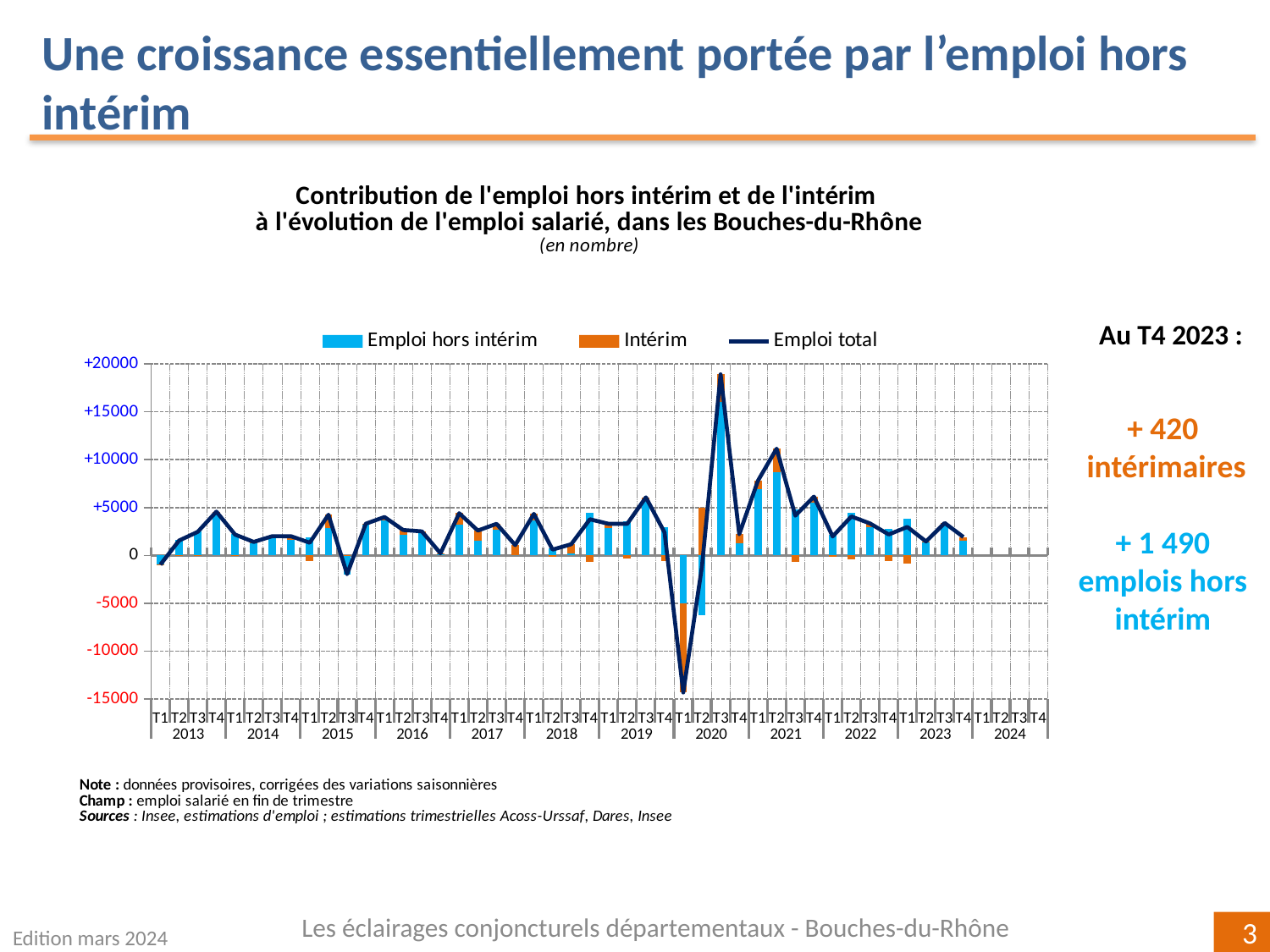
What colour are the Intérim bars in the chart? Orange Is the Emploi total value for T2 2021 greater or less than +5000? greater What kind of chart is shown on the slide? Combined bar and line chart Is the Emploi total value for T1 2020 greater or less than -10000? less According to the slide, what is the contribution of emploi hors intérim at T4 2023? + 1 490 In which quarter does the Emploi total line reach its lowest value? T1 2020 According to the slide, what is the contribution of intérim at T4 2023? + 420 Which is larger, the Emploi total value for T3 2020 or for T2 2021? T3 2020 How many series does the chart legend list? 3 Is the Emploi total value for T3 2020 greater or less than +15000? greater In which quarter does the Emploi total line reach its highest value? T3 2020 Does the Emploi total line rise or fall from T3 2020 to T4 2020? fall